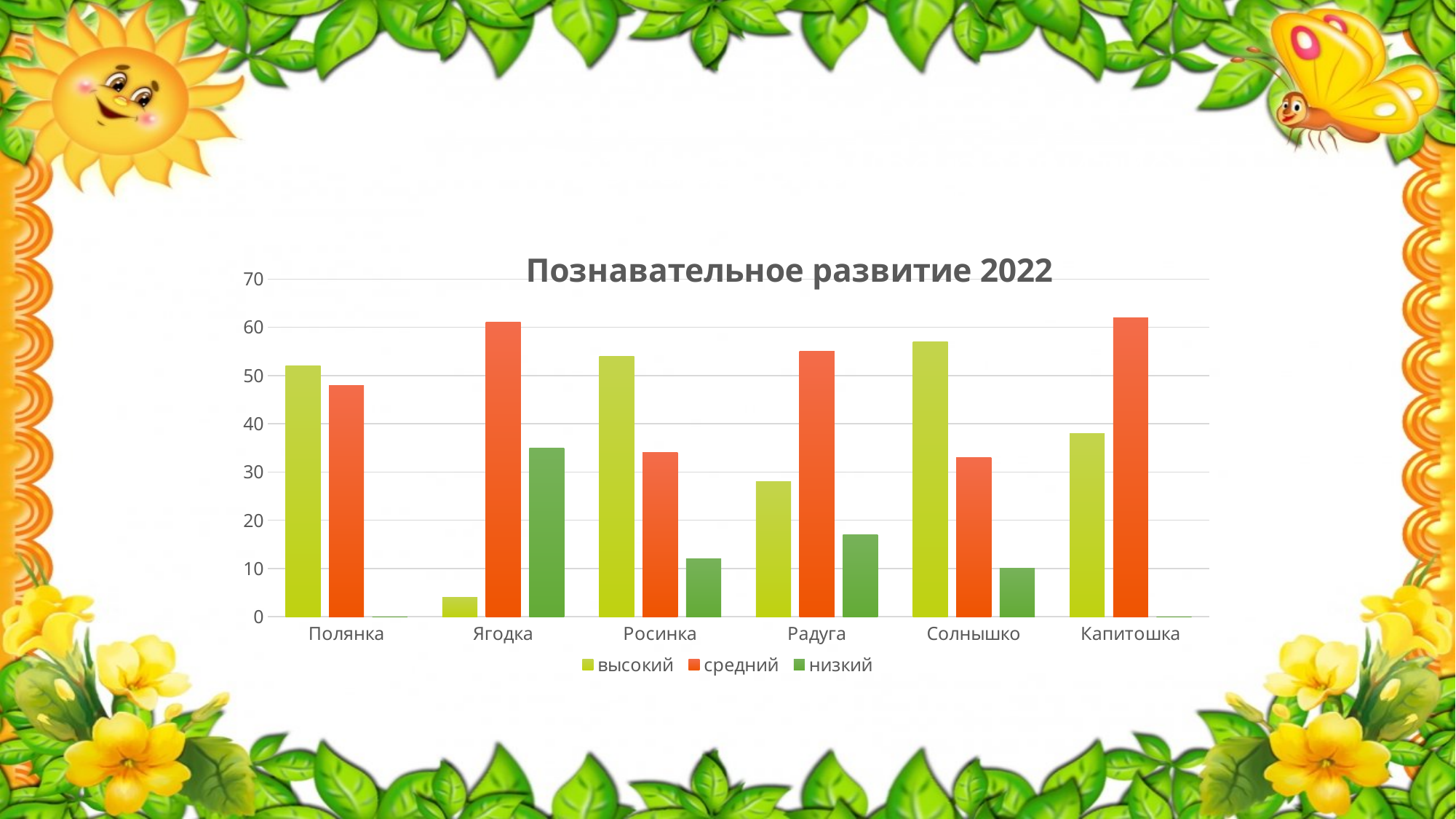
Is the value for высокий at Ягодка greater or less than 10? less Is the value for средний at Капитошка greater or less than 50? greater How many series does the legend list? 3 Which category has the lowest value for the series высокий? Ягодка Which category has the highest value for the series низкий? Ягодка What kind of chart is shown on the slide? bar chart For Радуга, which is larger: the value for высокий or the value for средний? средний What is the title of the chart? Познавательное развитие 2022 For Росинка, which is larger: the value for средний or the value for низкий? средний Is the value for высокий at Росинка greater or less than 50? greater How many categories are shown on the x axis? 6